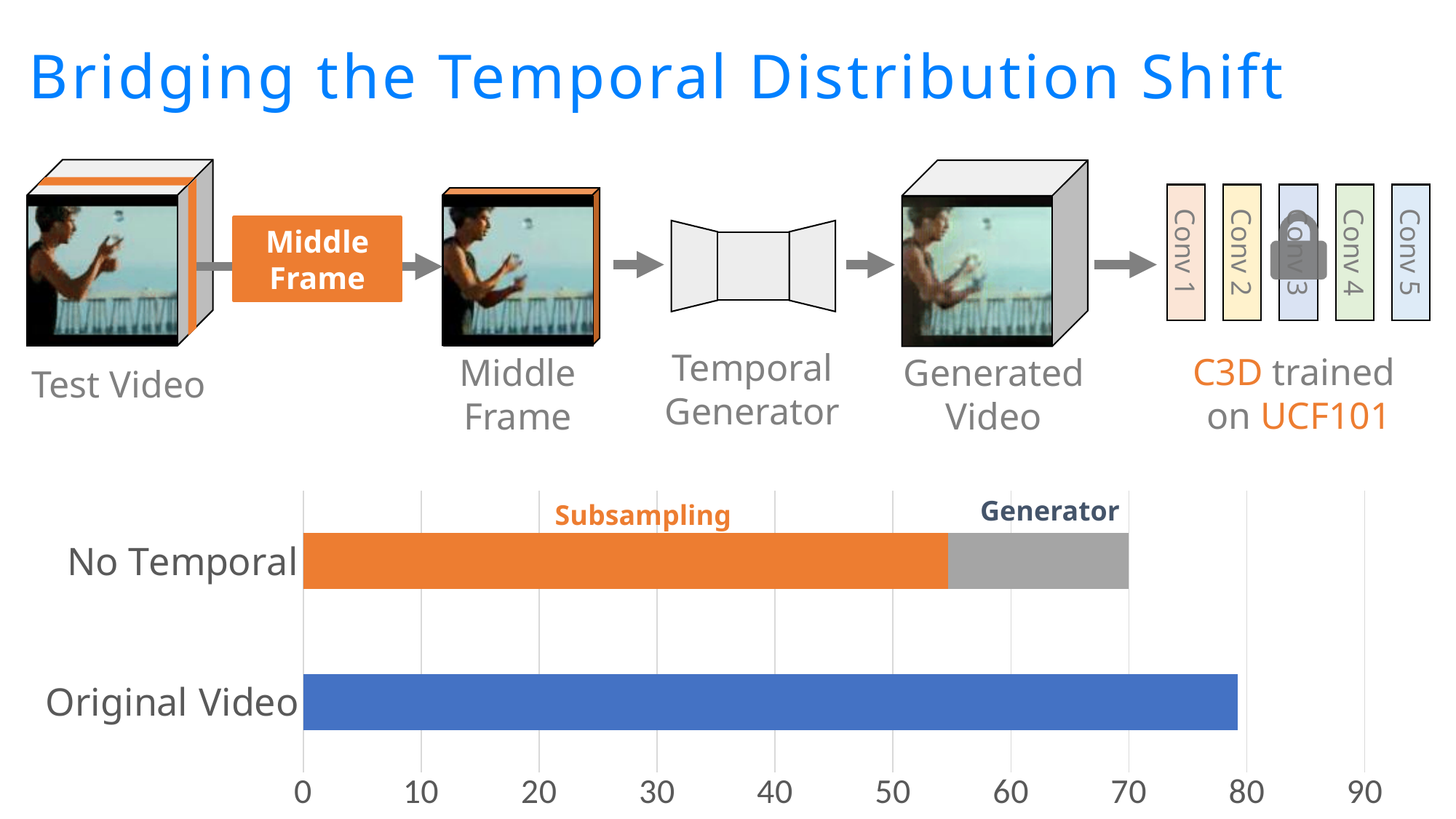
What label is given to the orange segment of the No Temporal bar? Subsampling Which category has the shortest total bar in the chart? No Temporal Is the Subsampling portion of the No Temporal bar greater or less than 50? greater Is the total length of the No Temporal bar greater or less than 80? less What label is given to the gray segment of the No Temporal bar? Generator Which category has the longest bar in the chart? Original Video Which is larger, the bar for Original Video or the total bar for No Temporal? Original Video What kind of chart is shown at the bottom of the slide? bar chart Is the value for Original Video greater or less than 70? greater How many categories are shown on the bar chart? 2